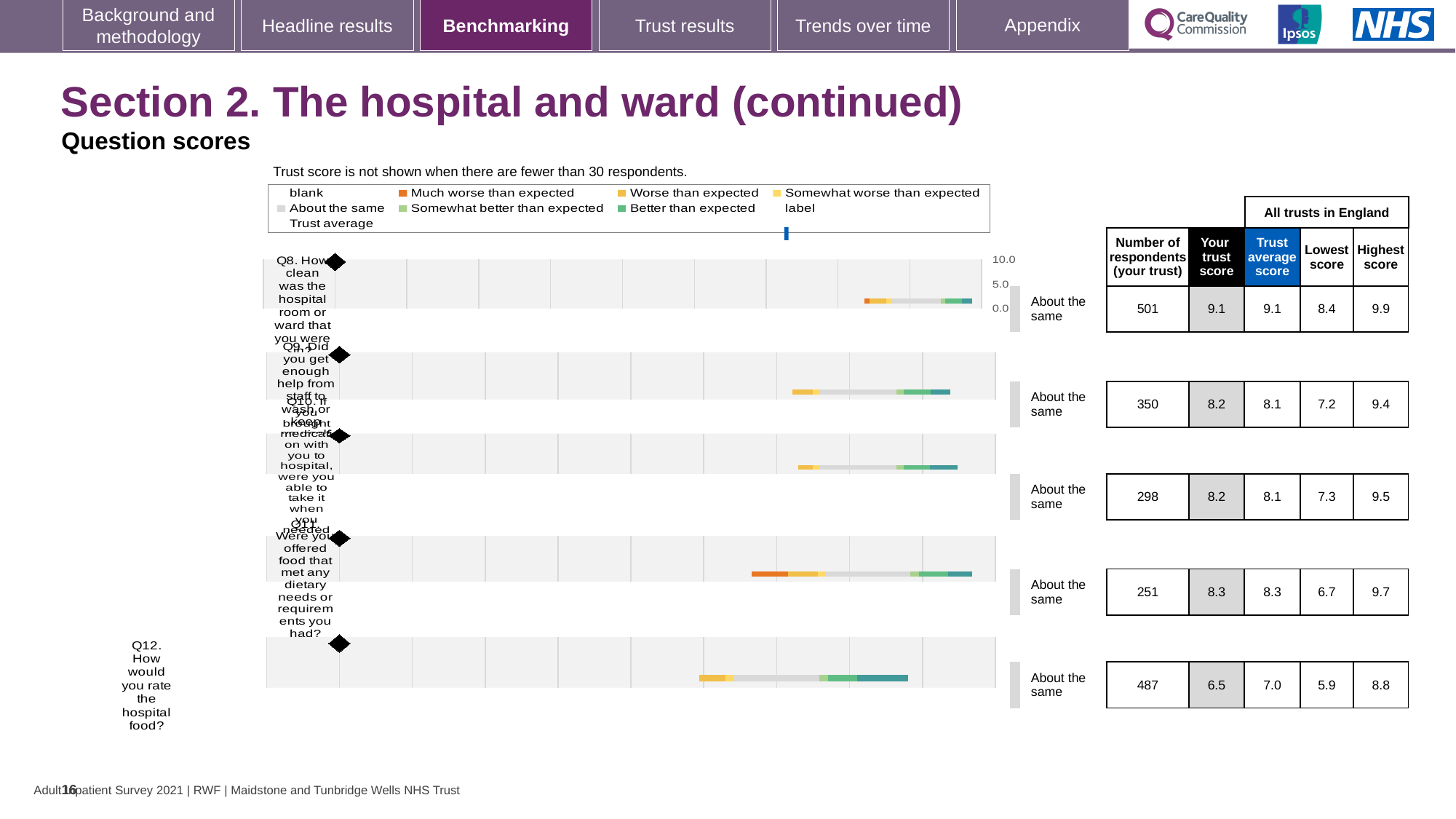
Which question has the highest 'Your trust score'? Q8 How many questions (categories) are plotted in the question scores chart? 5 What kind of chart is used to show the question scores on this slide? bar chart What is the 'Your trust score' for Q12 (how would you rate the hospital food)? 6.5 What is the lowest score across all trusts in England for Q11 (were you offered food that met any dietary needs)? 6.7 What is the highest score across all trusts in England for Q10 (medication brought with you to hospital)? 9.5 What is the difference between the trust average score and 'Your trust score' for Q12? 0.5 Which question has the lowest 'Your trust score'? Q12 What is the 'Your trust score' for Q8 (how clean was the hospital room or ward)? 9.1 What is the number of respondents for Q9 (did you get enough help from staff to wash or keep yourself clean)? 350 What benchmark category is shown for Q12 (how would you rate the hospital food)? About the same Which is larger for Q11: 'Your trust score' or the lowest score across all trusts in England? Your trust score